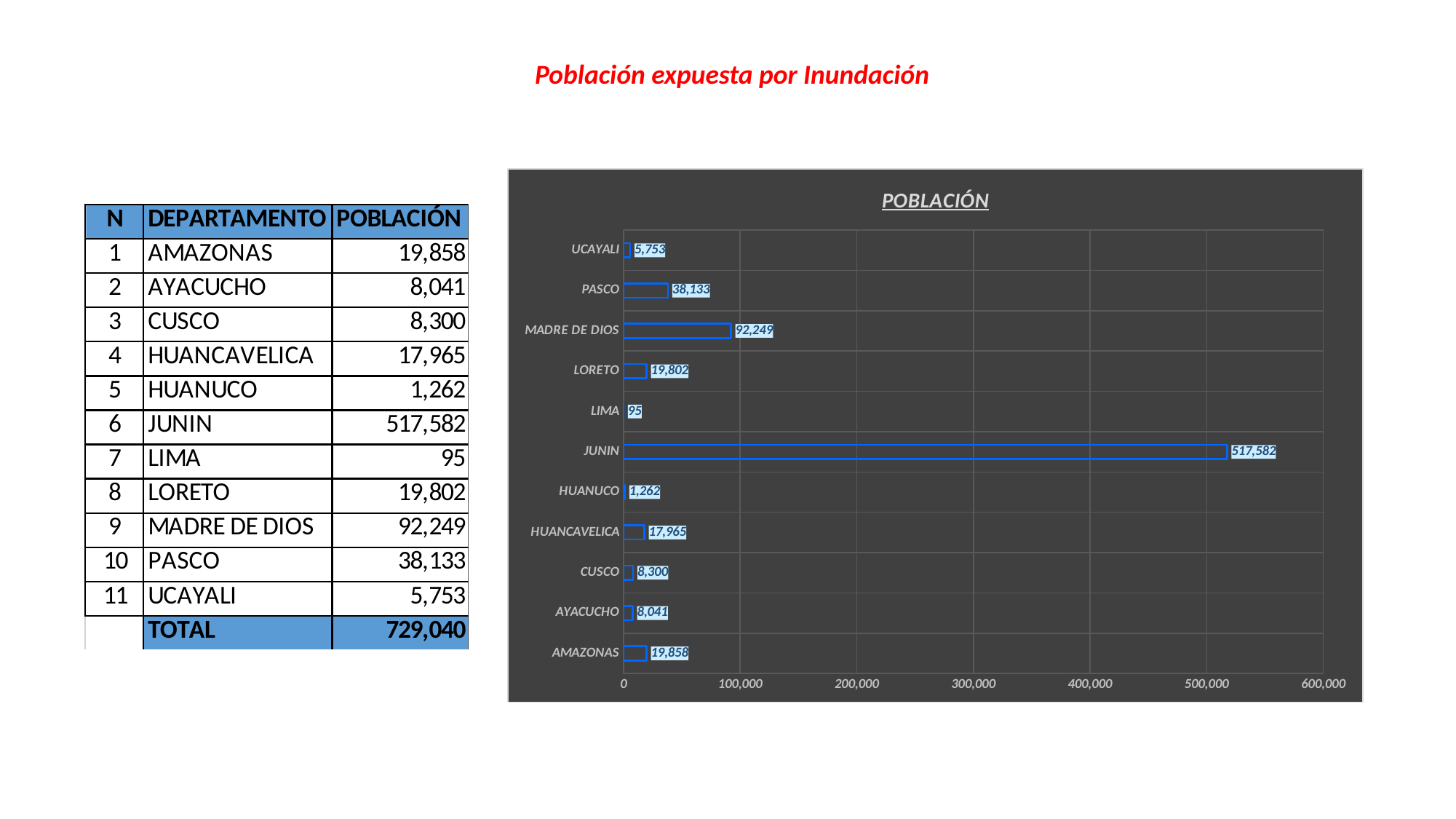
Which department has the highest value in the POBLACIÓN chart? JUNIN What kind of chart is the POBLACIÓN chart? bar chart What is the value for LIMA in the POBLACIÓN chart? 95 What is the value for JUNIN in the POBLACIÓN chart? 517,582 What is the difference between the values for PASCO and LORETO in the POBLACIÓN chart? 18,331 Is the value for JUNIN in the POBLACIÓN chart greater or less than 500,000? greater Which is larger in the POBLACIÓN chart, the value for AMAZONAS or the value for HUANCAVELICA? AMAZONAS Which department has the lowest value in the POBLACIÓN chart? LIMA How many departments are plotted in the POBLACIÓN chart? 11 What is the title of the chart on the slide? POBLACIÓN What is the value for PASCO in the POBLACIÓN chart? 38,133 What is the value for MADRE DE DIOS in the POBLACIÓN chart? 92,249